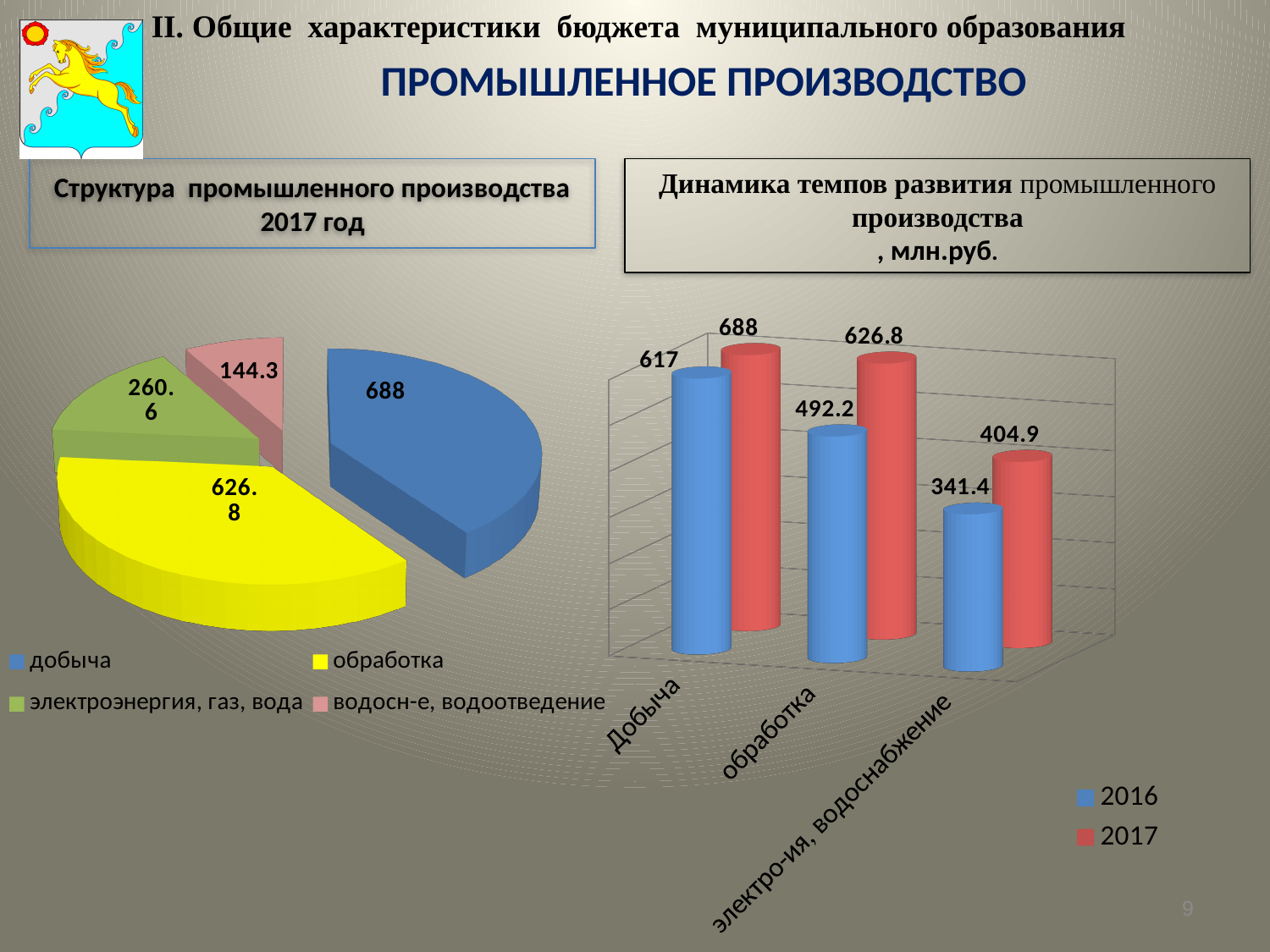
In the bar chart 'Динамика темпов развития промышленного производства, млн.руб.', which category has the lowest value in 2016? электро-ия, водоснабжение In the pie chart 'Структура промышленного производства 2017 год', which category has the smallest slice? водосн-е, водоотведение In the pie chart 'Структура промышленного производства 2017 год', what is the value for добыча? 688 In the bar chart 'Динамика темпов развития промышленного производства, млн.руб.', which is larger for Добыча: 2016 or 2017? 2017 In the bar chart 'Динамика темпов развития промышленного производства, млн.руб.', what is the value for электро-ия, водоснабжение in 2017? 404.9 In the pie chart 'Структура промышленного производства 2017 год', what is the difference between добыча and электроэнергия, газ, вода? 427.4 In the bar chart 'Динамика темпов развития промышленного производства, млн.руб.', how many series does the legend list? 2 In the pie chart 'Структура промышленного производства 2017 год', what is the value for водосн-е, водоотведение? 144.3 In the bar chart 'Динамика темпов развития промышленного производства, млн.руб.', what is the value for обработка in 2016? 492.2 What kind of chart is 'Динамика темпов развития промышленного производства, млн.руб.'? bar chart In the pie chart 'Структура промышленного производства 2017 год', how many slices are there? 4 In the bar chart 'Динамика темпов развития промышленного производства, млн.руб.', by how much did обработка increase from 2016 to 2017? 134.6